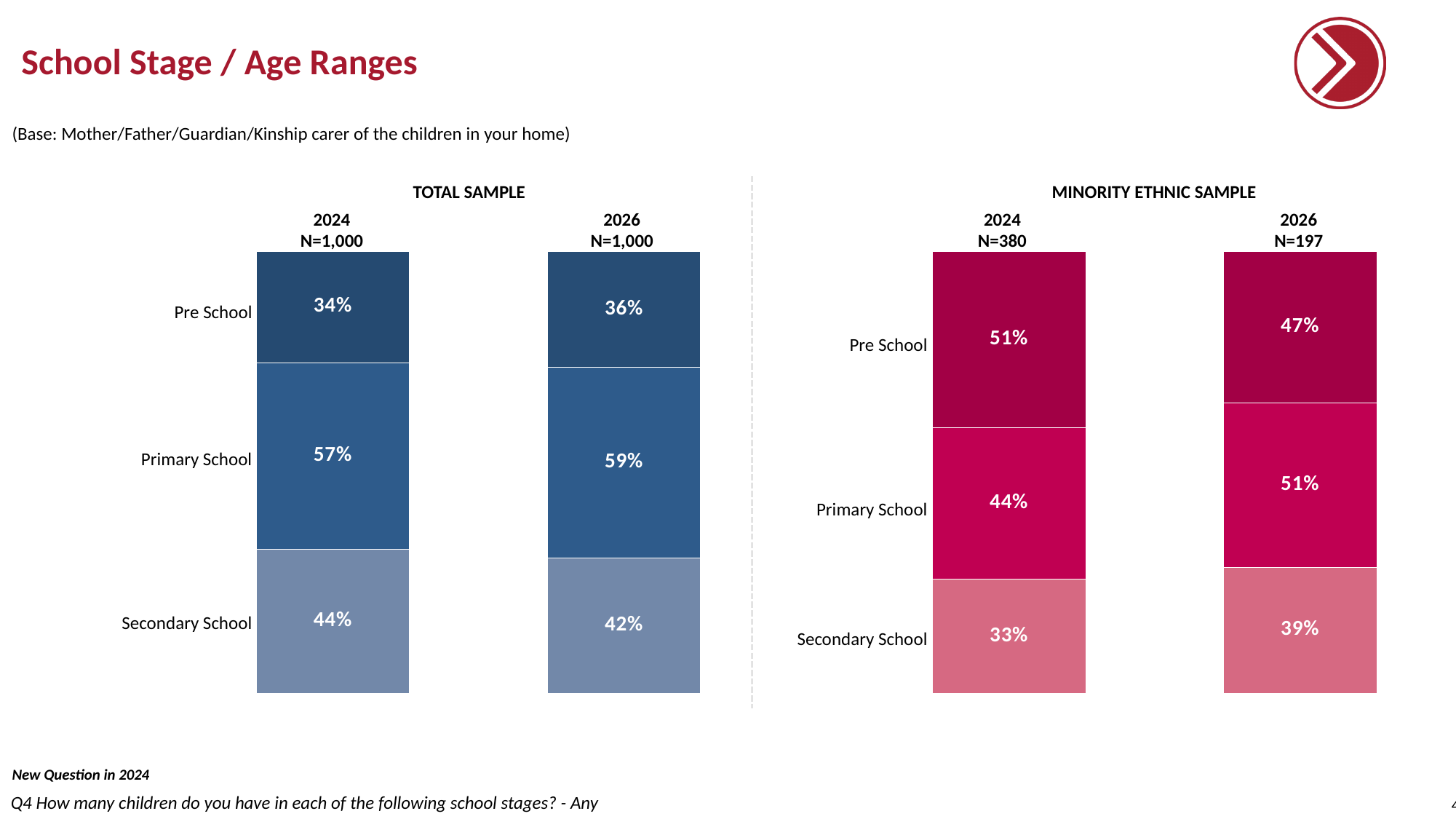
In the TOTAL SAMPLE chart, what is the difference between the Primary School values for 2026 and 2024? 2% In the TOTAL SAMPLE chart, which school stage has the highest value in 2026? Primary School In the MINORITY ETHNIC SAMPLE chart, is the Secondary School value larger in 2024 or 2026? 2026 What kind of chart is the MINORITY ETHNIC SAMPLE chart? Stacked bar chart What is the sample size (N) shown for the 2026 bar in the MINORITY ETHNIC SAMPLE chart? N=197 In the TOTAL SAMPLE chart, what is the value for Secondary School in 2026? 42% In the MINORITY ETHNIC SAMPLE chart, what is the difference between the Pre School values for 2024 and 2026? 4% In the TOTAL SAMPLE chart, what is the value for Primary School in 2024? 57% How many school stages are shown in the TOTAL SAMPLE chart? 3 In the MINORITY ETHNIC SAMPLE chart, what is the value for Pre School in 2024? 51% In the MINORITY ETHNIC SAMPLE chart, which school stage has the lowest value in 2024? Secondary School In the MINORITY ETHNIC SAMPLE chart, what is the value for Secondary School in 2026? 39%